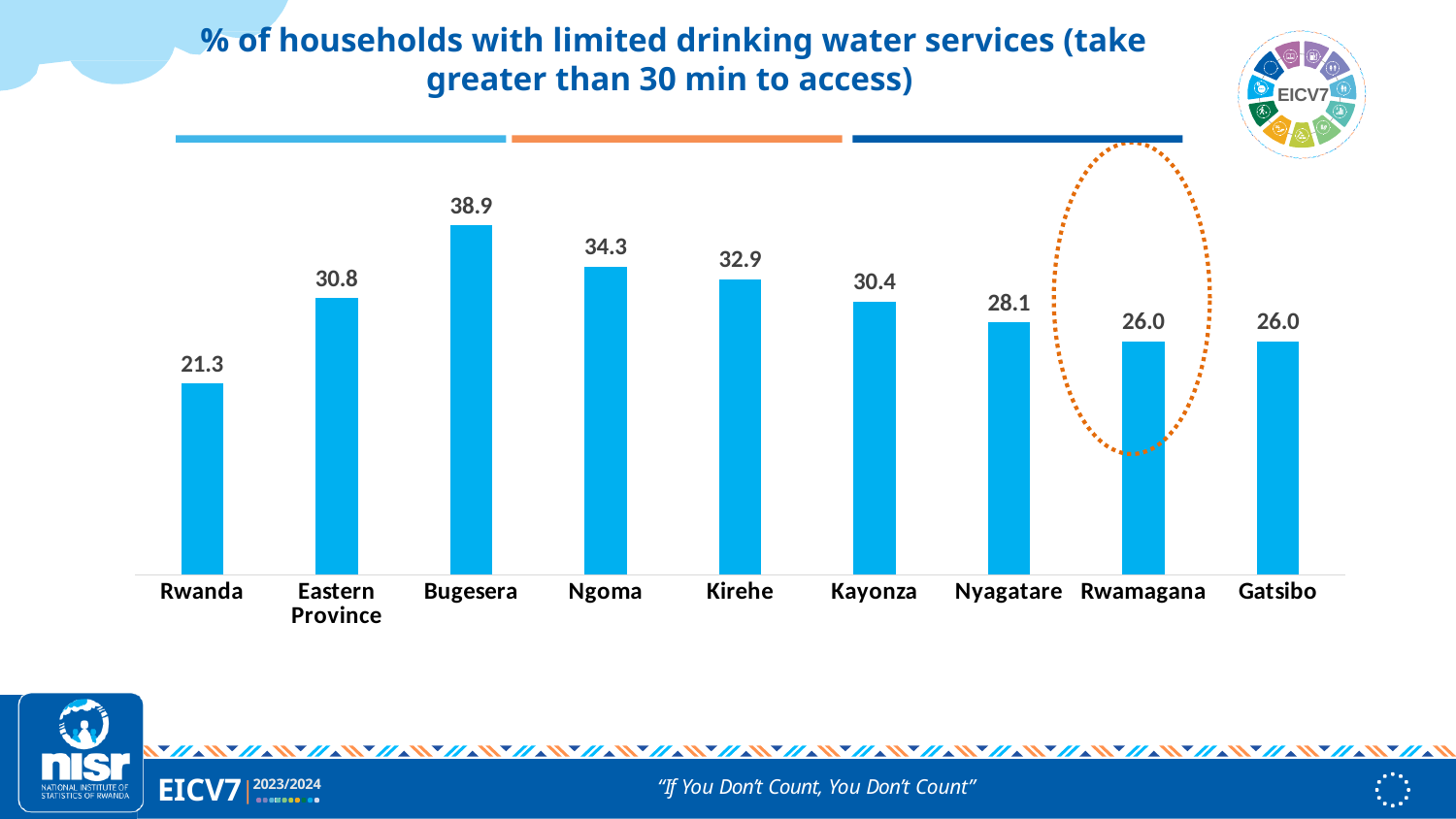
What is the difference between the values for Bugesera and Rwanda? 17.6 What kind of chart is this? Bar chart What is the value for Rwanda? 21.3 What is the difference between the values for Ngoma and Kirehe? 1.4 Which is larger, the value for Kayonza or the value for Nyagatare? Kayonza How many categories are shown on the x axis? 9 What is the value for Nyagatare? 28.1 Which category has the lowest value? Rwanda Which category is circled with a dotted orange outline? Rwamagana Which category has the highest value? Bugesera What is the title of the chart? % of households with limited drinking water services (take greater than 30 min to access) What is the value for Bugesera? 38.9